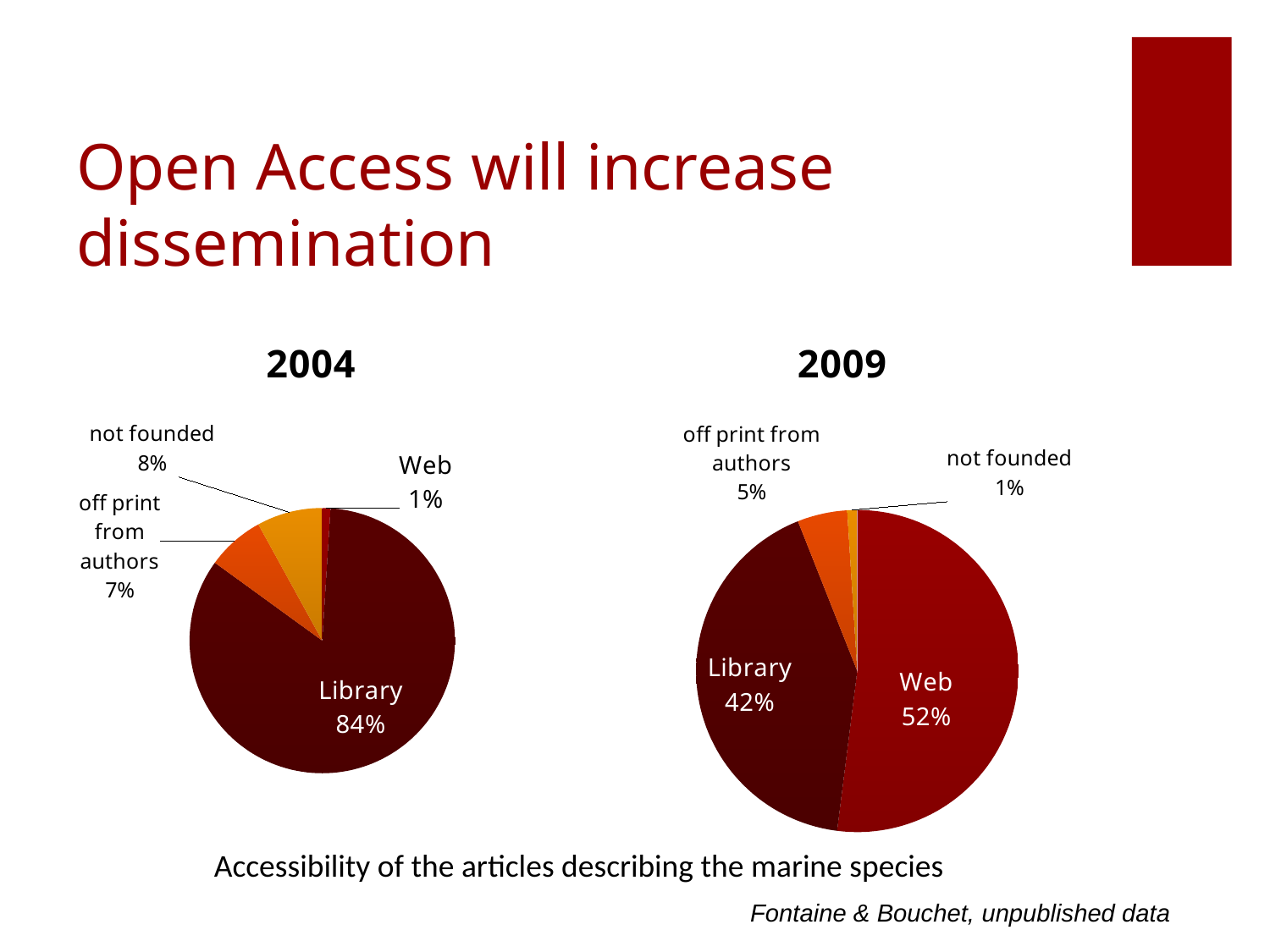
In the 2004 pie chart, what is the share for Web? 1% In the 2004 pie chart, what share of articles is accessible via Library? 84% In the 2004 pie chart, which category has the largest share? Library In the 2009 pie chart, which category has the smallest share? not founded In the 2004 pie chart, what is the difference between the not founded share and the off print from authors share? 1% What type of chart is used for the 2004 data? Pie chart What is the title of the chart on the right? 2009 How many categories are shown in the 2009 pie chart? 4 What is the difference between the Library share in 2004 and the Library share in 2009? 42% In the 2009 pie chart, what share of articles is accessible via Web? 52% In the 2009 pie chart, what is the share for off print from authors? 5% In the 2009 pie chart, which is larger, Web or Library? Web